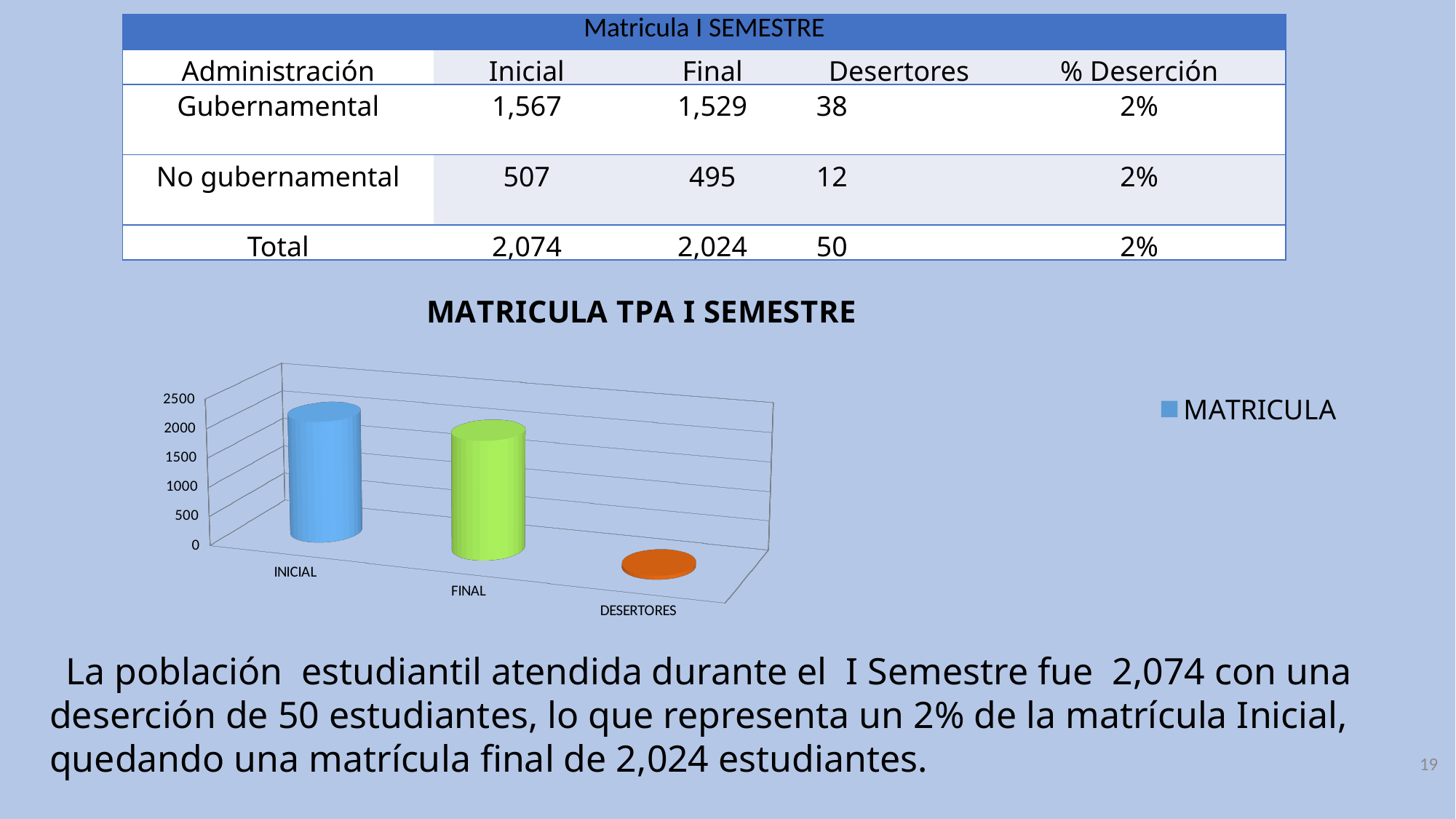
In the MATRICULA TPA I SEMESTRE chart, which is larger, the value for INICIAL or the value for DESERTORES? INICIAL How many series does the legend of the MATRICULA TPA I SEMESTRE chart list? 1 What is the name of the series shown in the legend of the MATRICULA TPA I SEMESTRE chart? MATRICULA In the MATRICULA TPA I SEMESTRE chart, which is larger, the value for FINAL or the value for DESERTORES? FINAL What is the highest value shown on the vertical axis of the MATRICULA TPA I SEMESTRE chart? 2500 What kind of chart is shown under the title MATRICULA TPA I SEMESTRE? bar chart Do the values in the MATRICULA TPA I SEMESTRE chart rise or fall from INICIAL to DESERTORES? fall In the MATRICULA TPA I SEMESTRE chart, is the value for DESERTORES greater or less than 500? less In the MATRICULA TPA I SEMESTRE chart, is the value for FINAL greater or less than 1000? greater In the MATRICULA TPA I SEMESTRE chart, is the value for INICIAL greater or less than 1500? greater Which category has the lowest value in the MATRICULA TPA I SEMESTRE chart? DESERTORES How many categories are plotted on the x axis of the MATRICULA TPA I SEMESTRE chart? 3